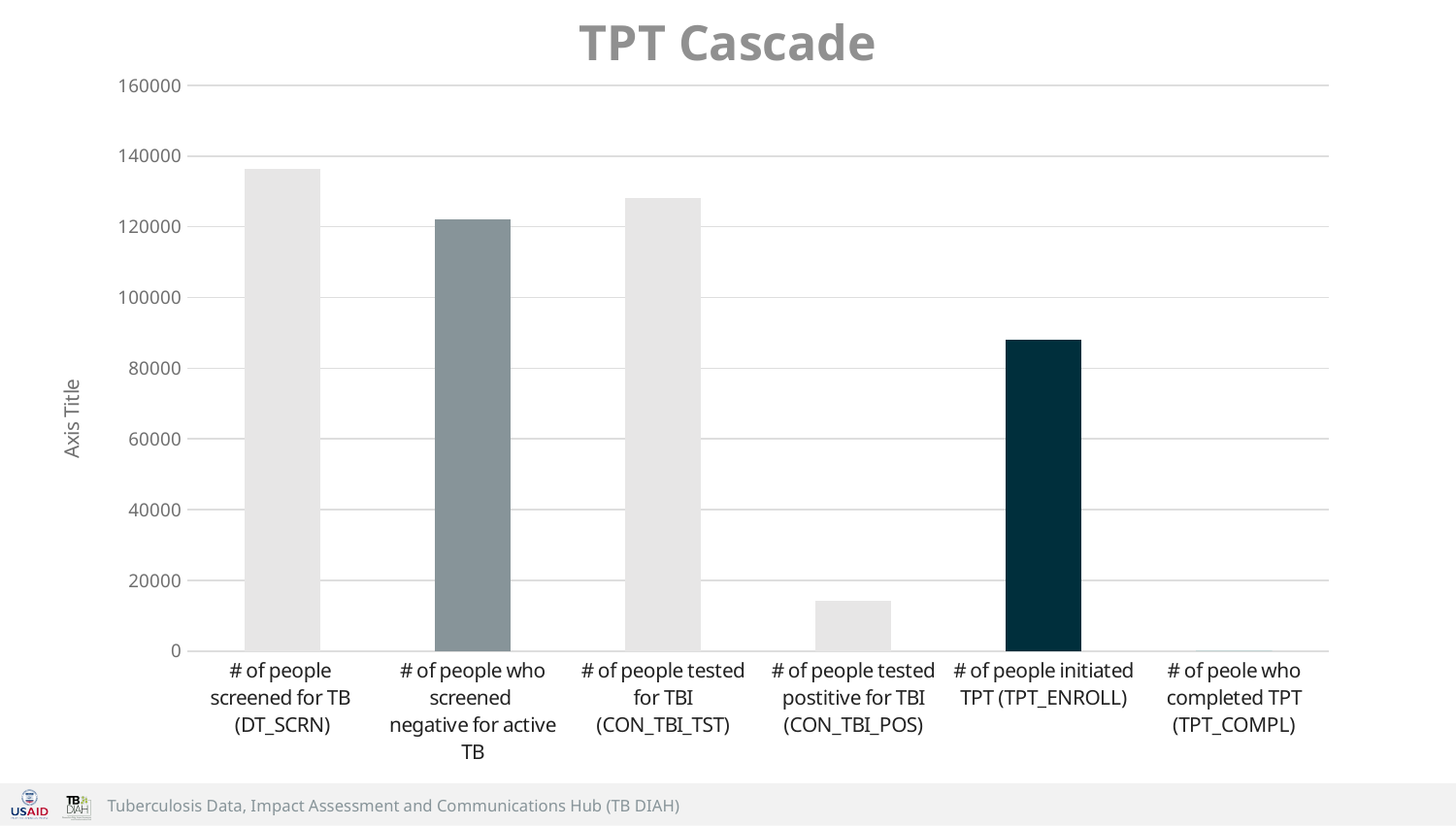
Which category has the highest bar in the chart? # of people screened for TB (DT_SCRN) Which is larger: the value for # of people initiated TPT (TPT_ENROLL) or the value for # of people tested postitive for TBI (CON_TBI_POS)? # of people initiated TPT (TPT_ENROLL) Is the value for # of people initiated TPT (TPT_ENROLL) greater or less than 100000? less How many categories are shown on the x axis of the chart? 6 Is the value for # of people tested for TBI (CON_TBI_TST) greater or less than 120000? greater What is the title of the chart? TPT Cascade What kind of chart is shown on the slide? bar chart Is the value for # of people tested postitive for TBI (CON_TBI_POS) greater or less than 20000? less Which is larger: the value for # of people screened for TB (DT_SCRN) or the value for # of people who screened negative for active TB? # of people screened for TB (DT_SCRN)